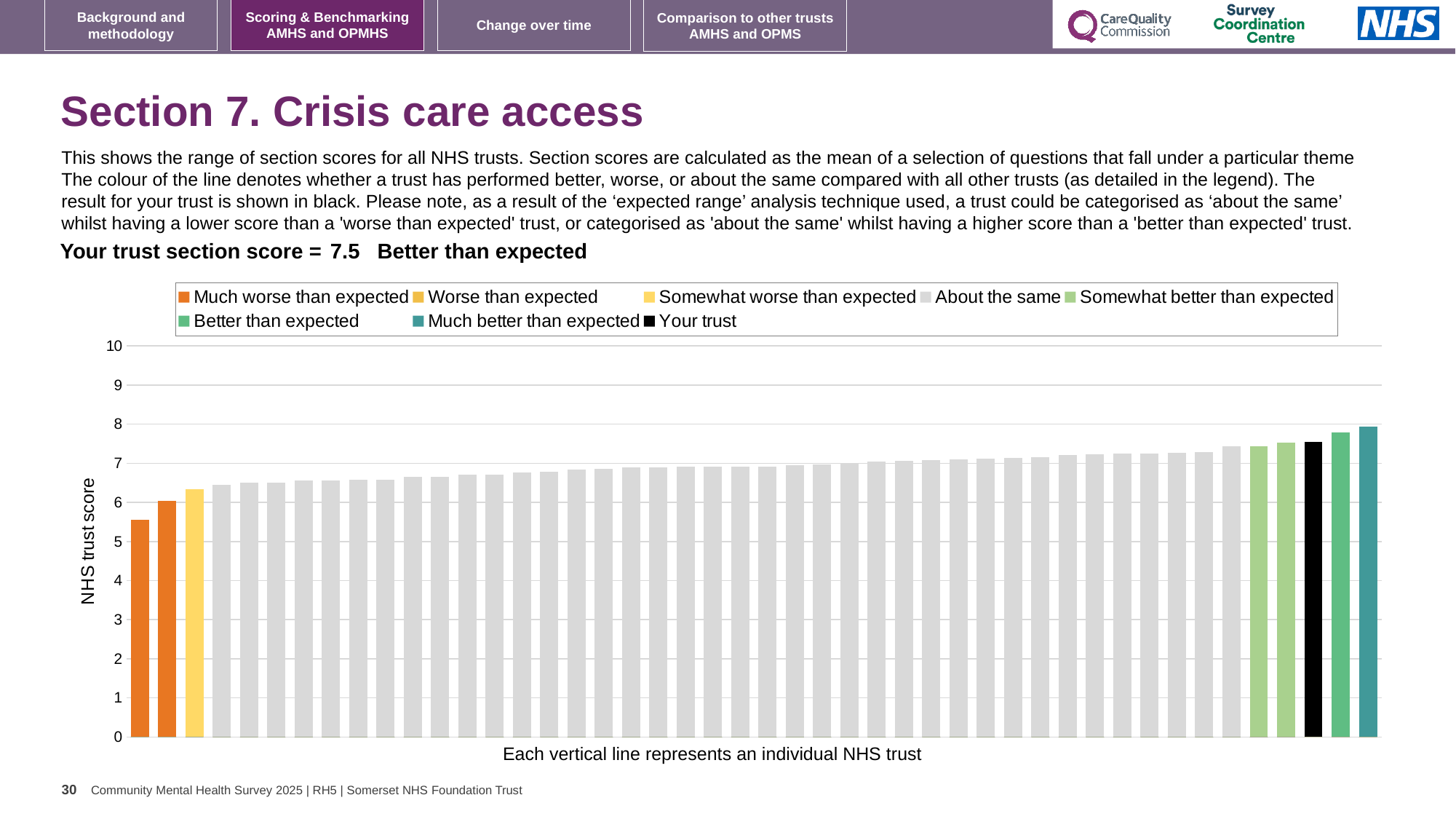
What kind of chart is shown on the slide? bar chart Is the value of the tallest bar in the chart greater or less than 7? greater Which legend category is your trust's section score classified as? Better than expected Which legend category does the tallest bar in the chart belong to? Much better than expected Is the value of the black 'Your trust' bar greater or less than 7? greater How many entries does the chart legend list? 8 What is the label on the vertical axis of the chart? NHS trust score Is the value of the shortest bar in the chart greater or less than 6? less How many bars are coloured as 'Much worse than expected'? 2 Do the bar values rise or fall from left to right across the chart? rise Which legend category does the shortest bar in the chart belong to? Much worse than expected What is the section score for your trust shown on the slide? 7.5